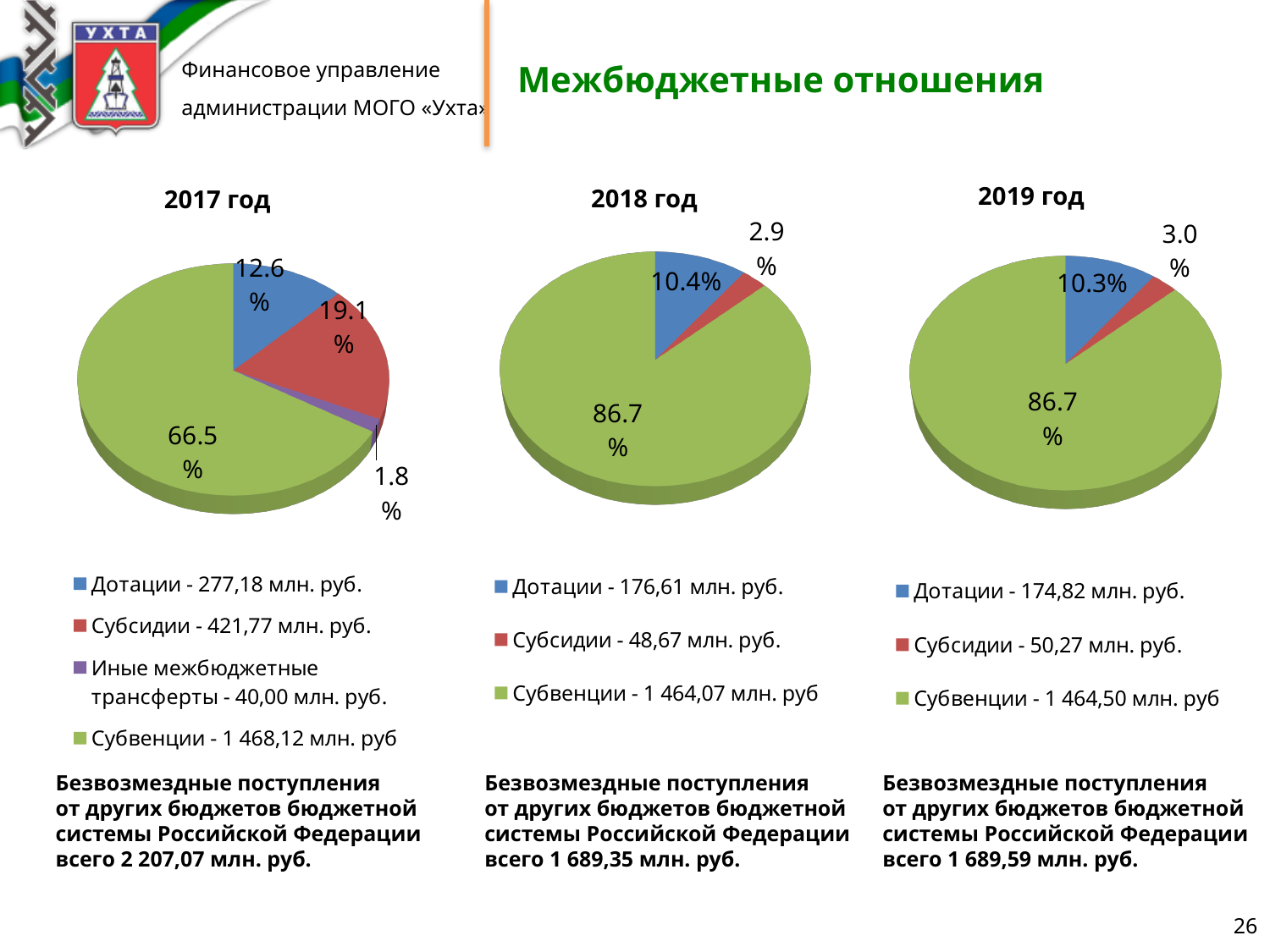
In the 2018 год chart, which category has the largest slice? Субвенции In the 2017 год chart, what share of the pie is Субвенции? 66.5% In the 2018 год chart, what share of the pie is Дотации? 10.4% How many entries does the legend of the 2019 год chart list? 3 In the 2019 год chart, what share of the pie is Субвенции? 86.7% What type of chart is used for the 2018 год data? Pie chart In the 2019 год chart, what is the difference in percentage points between Дотации and Субсидии? 7.3 In the 2019 год chart, which is larger, Дотации or Субсидии? Дотации How many slices does the 2017 год pie chart have? 4 In the 2017 год chart, which category has the smallest slice? Иные межбюджетные трансферты